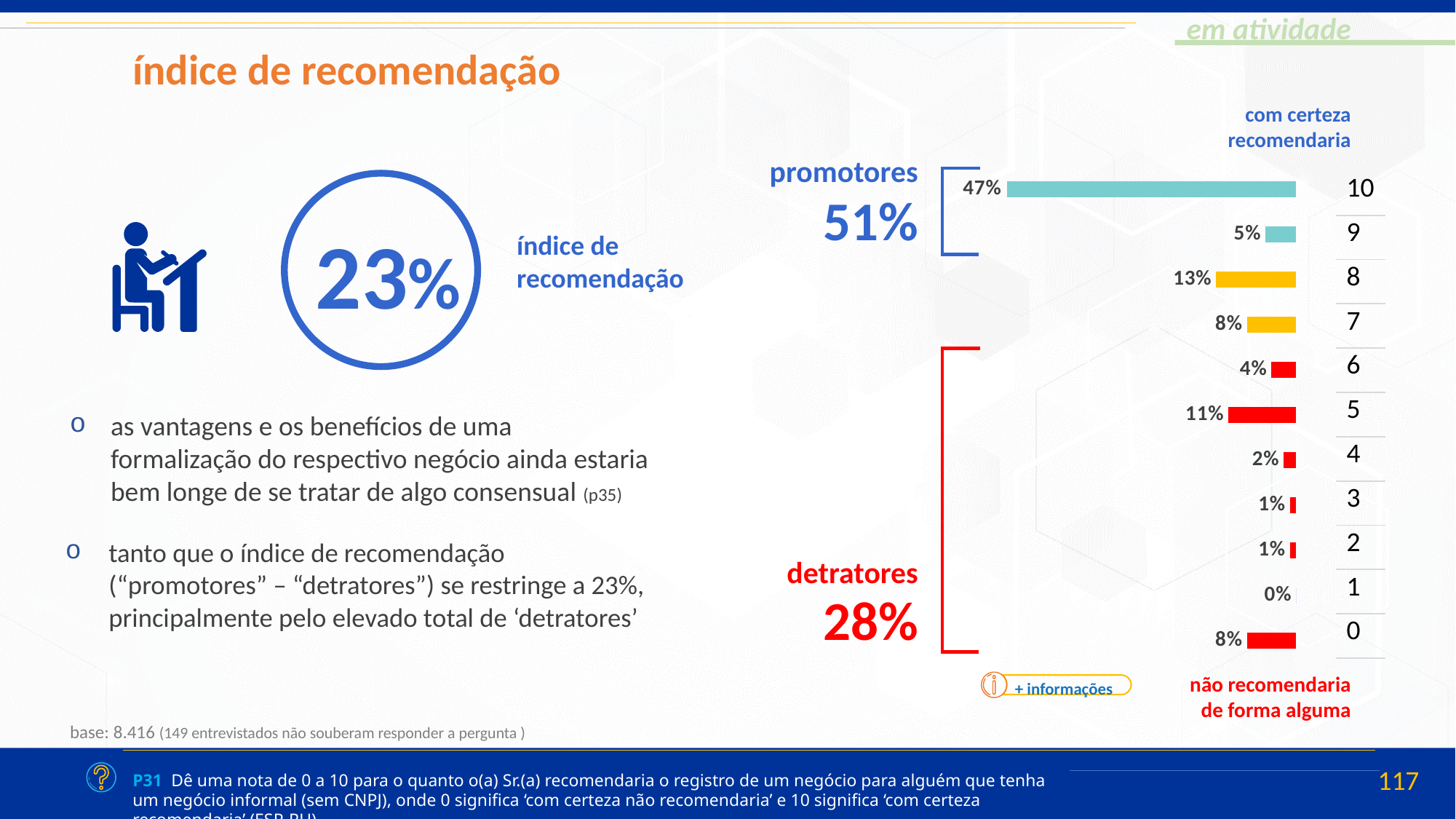
What percentage is shown for detratores? 28% Which score has the lowest percentage of respondents? 1 Which score has the highest percentage of respondents? 10 What percentage of respondents gave a score of 10? 47% What percentage of respondents gave a score of 8? 13% What type of chart is used to show the distribution of scores? bar chart What is the combined percentage for scores 9 and 10 (promotores)? 52% What percentage of respondents gave a score of 5? 11% How many score categories are shown in the bar chart? 11 Which has a larger percentage, score 8 or score 7? score 8 What percentage of respondents gave a score of 0? 8% What is the difference between the percentage for score 10 and the percentage for score 9? 42%